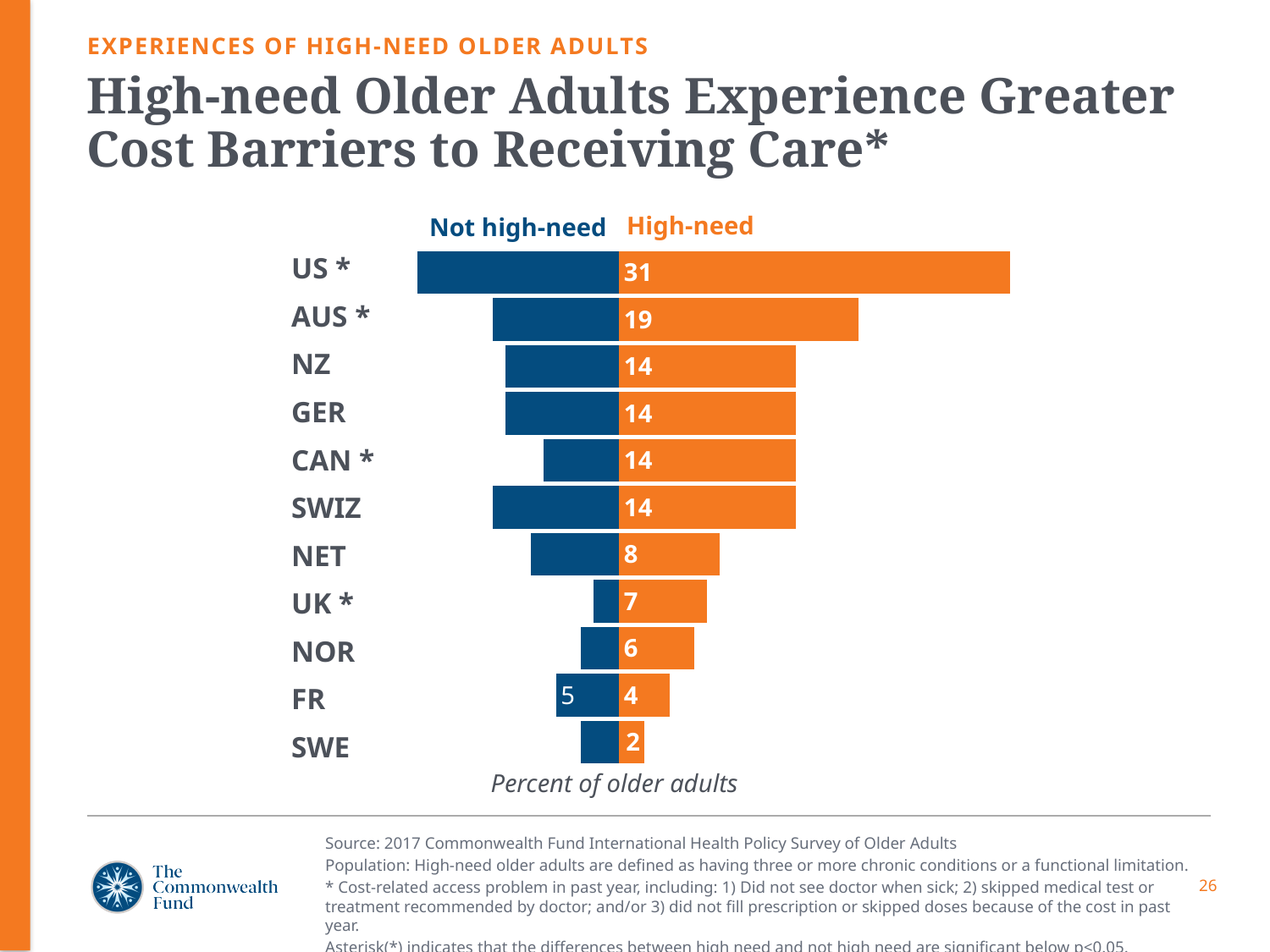
What is the High-need value for SWE? 2 What type of chart is shown on the slide? Bar chart What is the difference between the High-need values for US * and AUS *? 12 Which country has the lowest High-need value? SWE How many series does the chart show? 2 Which has a larger High-need value, NET or UK *? NET How many countries are shown in the chart? 11 What is the Not high-need value for FR? 5 What is the High-need value for US *? 31 Which country has the highest High-need value? US * For FR, what is the difference between the Not high-need value and the High-need value? 1 What is the High-need value for AUS *? 19